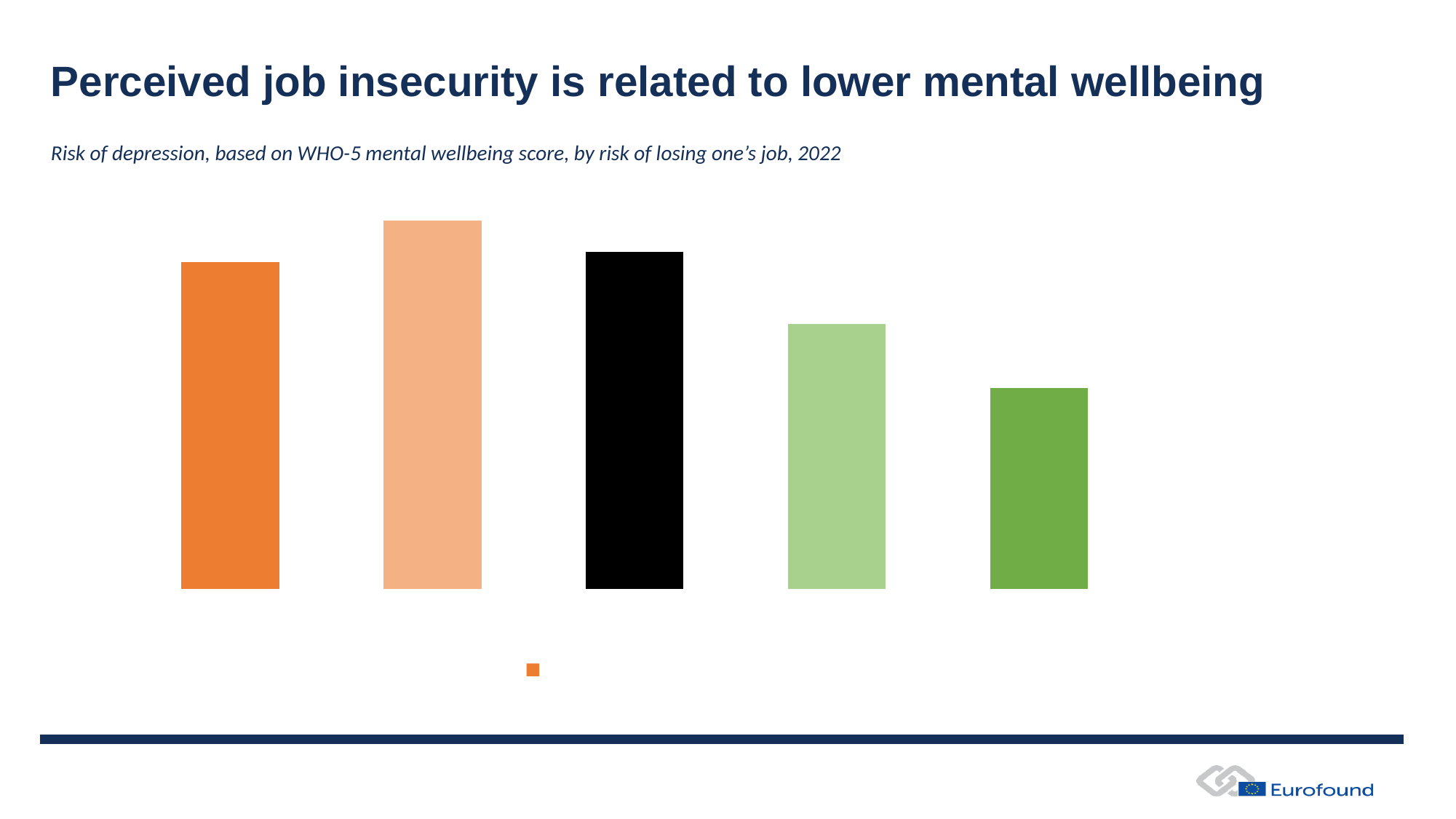
Which is taller: the first bar from the left or the third bar from the left? The third bar What is the subtitle describing the chart on the slide? Risk of depression, based on WHO-5 mental wellbeing score, by risk of losing one's job, 2022 Which bar is the tallest in the chart, by its position from the left? The second bar Which bar is the shortest in the chart, by its position from the left? The fifth bar Do the bar heights rise or fall from the third bar to the fifth bar? Fall Which is taller: the second bar from the left or the fourth bar from the left? The second bar What colour is the tallest bar in the chart? Light orange What kind of chart is shown on the slide? Bar chart How many bars are plotted in the chart? 5 Which is taller: the fourth bar from the left or the fifth bar from the left? The fourth bar